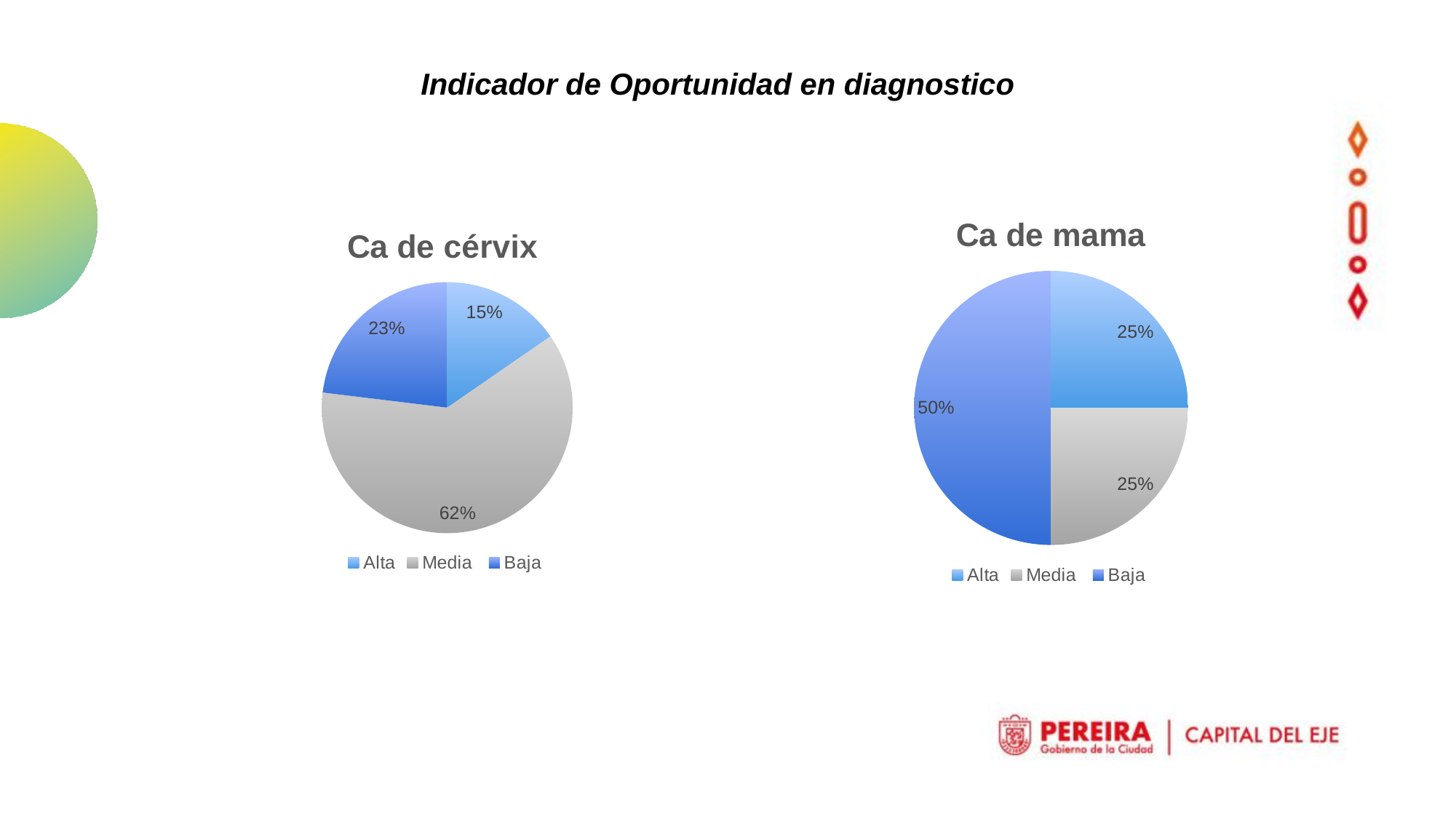
In the 'Ca de mama' chart, which category has the largest slice? Baja In the 'Ca de cérvix' chart, what share does Baja have? 23% In the 'Ca de cérvix' chart, which category has the smallest slice? Alta In the 'Ca de cérvix' chart, what share does Alta have? 15% In the 'Ca de mama' chart, what share does Alta have? 25% In the 'Ca de mama' chart, what share does Baja have? 50% How many slices does the 'Ca de mama' chart have? 3 In the 'Ca de cérvix' chart, which category has the largest slice? Media What kind of chart is the 'Ca de cérvix' chart? Pie chart In the 'Ca de cérvix' chart, which is larger, Baja or Alta? Baja In the 'Ca de cérvix' chart, what share does Media have? 62% In the 'Ca de cérvix' chart, what is the difference between the Media and Baja shares? 39%